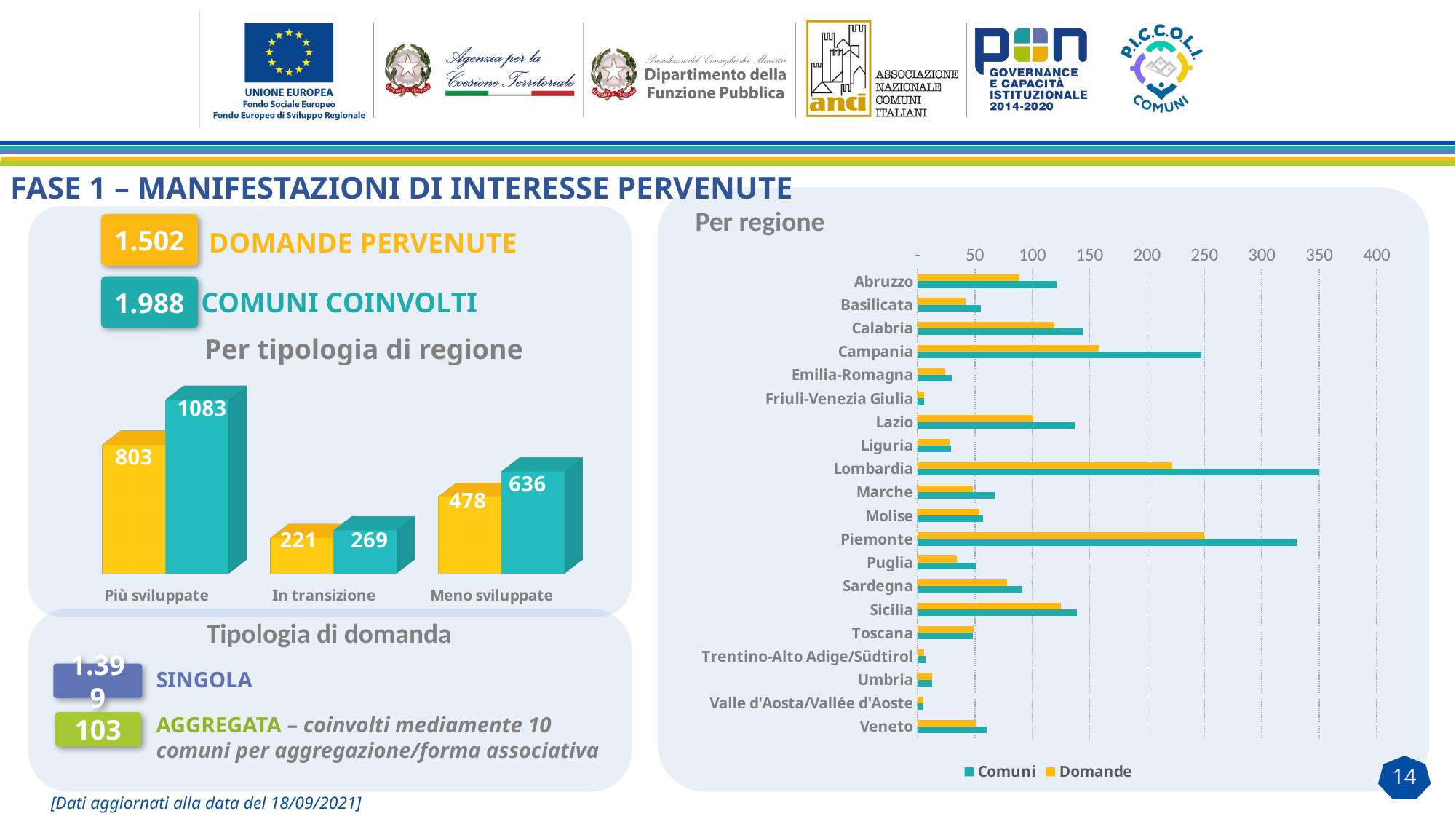
In the 'Per tipologia di regione' chart, what is the value of the yellow bar for 'Più sviluppate'? 803 In the 'Per regione' chart, is the Comuni value for Campania greater or less than 200? greater In the 'Per regione' chart, how many series does the legend list? 2 In the 'Per regione' chart, is the Domande value for Basilicata greater or less than 50? less In the 'Per tipologia di regione' chart, which category has the highest teal bar? Più sviluppate In the 'Per regione' chart, how many regions are listed on the vertical axis? 20 In the 'Per regione' chart, which region has the highest value for Comuni? Lombardia In the 'Per tipologia di regione' chart, what is the value of the teal bar for 'Meno sviluppate'? 636 What kind of chart is the 'Per tipologia di regione' chart? Bar chart In the 'Per regione' chart, which has the larger Comuni value, Abruzzo or Basilicata? Abruzzo In the 'Per tipologia di regione' chart, what is the difference between the teal bar and the yellow bar for 'In transizione'? 48 In the 'Per tipologia di regione' chart, how many categories are shown on the x axis? 3